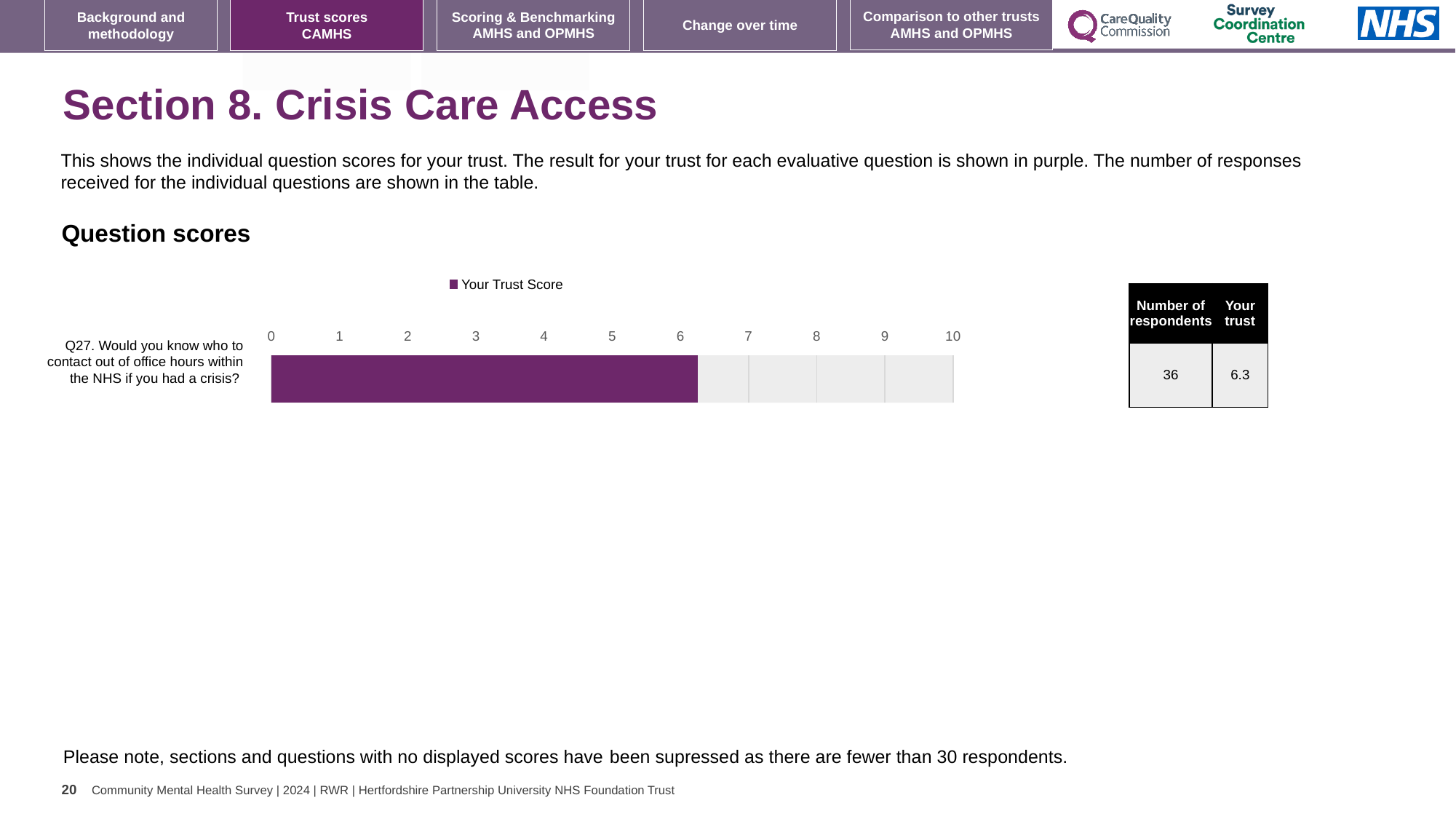
How many questions (bars) are plotted in the Question scores chart? 1 How many series does the legend of the Question scores chart list? 1 Is the bar for Q27 in the Question scores chart greater or less than 7? less What is the name of the series shown in the legend of the Question scores chart? Your Trust Score What is the maximum value shown on the x axis of the Question scores chart? 10 What kind of chart is shown under "Question scores"? bar chart How many respondents answered Q27 according to the table next to the chart? 36 Which question is plotted in the Question scores chart? Q27. Would you know who to contact out of office hours within the NHS if you had a crisis? What is the trust score for Q27 (Would you know who to contact out of office hours within the NHS if you had a crisis?) as shown in the table? 6.3 Is the bar for Q27 in the Question scores chart greater or less than 5? greater